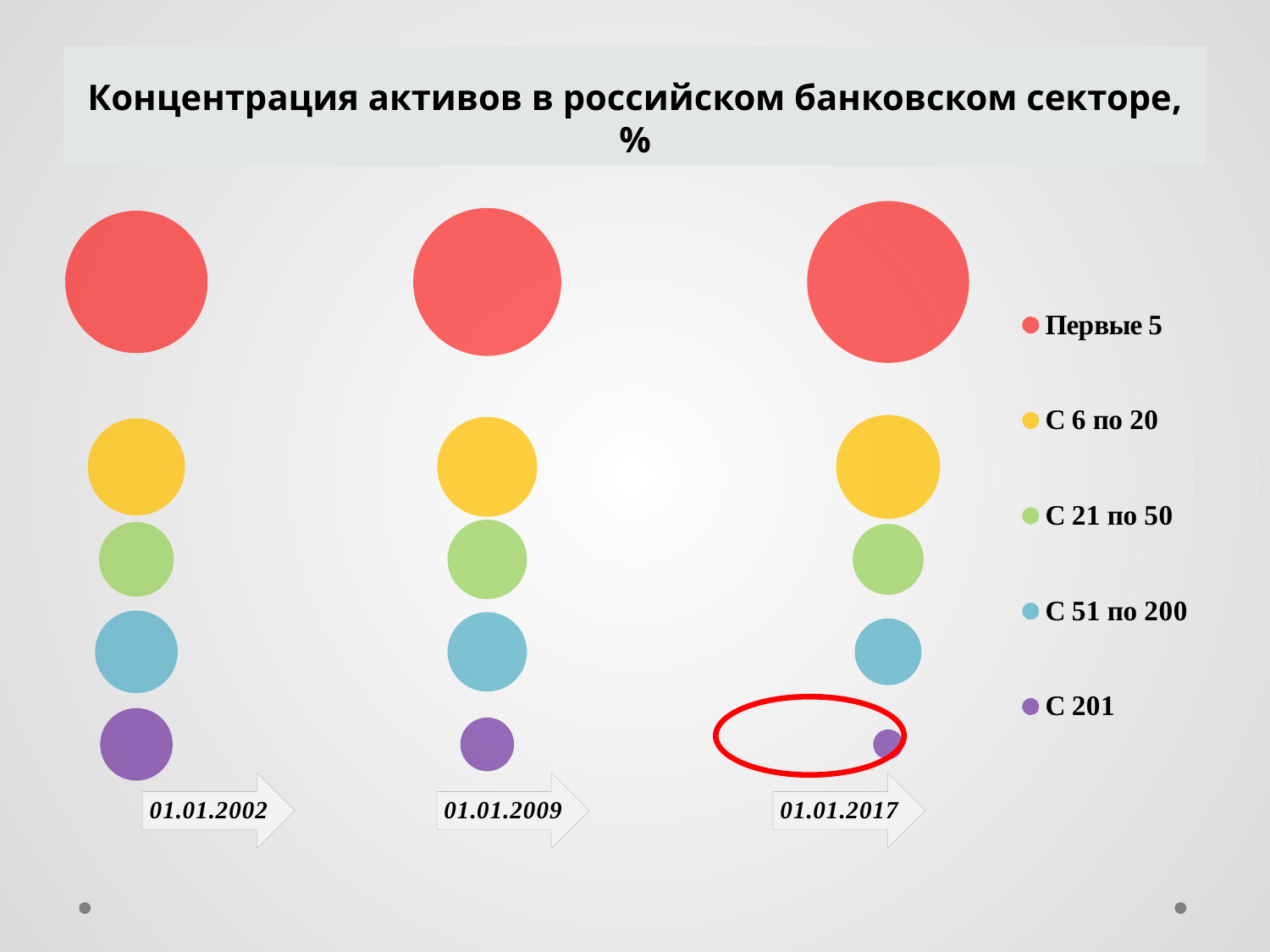
At 01.01.2017, which bubble is larger: С 6 по 20 or С 21 по 50? С 6 по 20 Which series' bubble is circled in red on the chart? С 201 Does the bubble for Первые 5 grow or shrink from 01.01.2002 to 01.01.2017? grow Which group has the smallest bubble at 01.01.2017? С 201 Does the bubble for С 201 grow or shrink from 01.01.2002 to 01.01.2017? shrink What kind of chart is shown on the slide? bubble chart What is the title of the chart? Концентрация активов в российском банковском секторе, % How many series does the legend list? 5 Which group has the smallest bubble at 01.01.2002? С 201 How many dates are shown along the bottom of the chart? 3 Which group has the largest bubble at 01.01.2017? Первые 5 For С 51 по 200, is the bubble larger at 01.01.2009 or at 01.01.2017? 01.01.2009